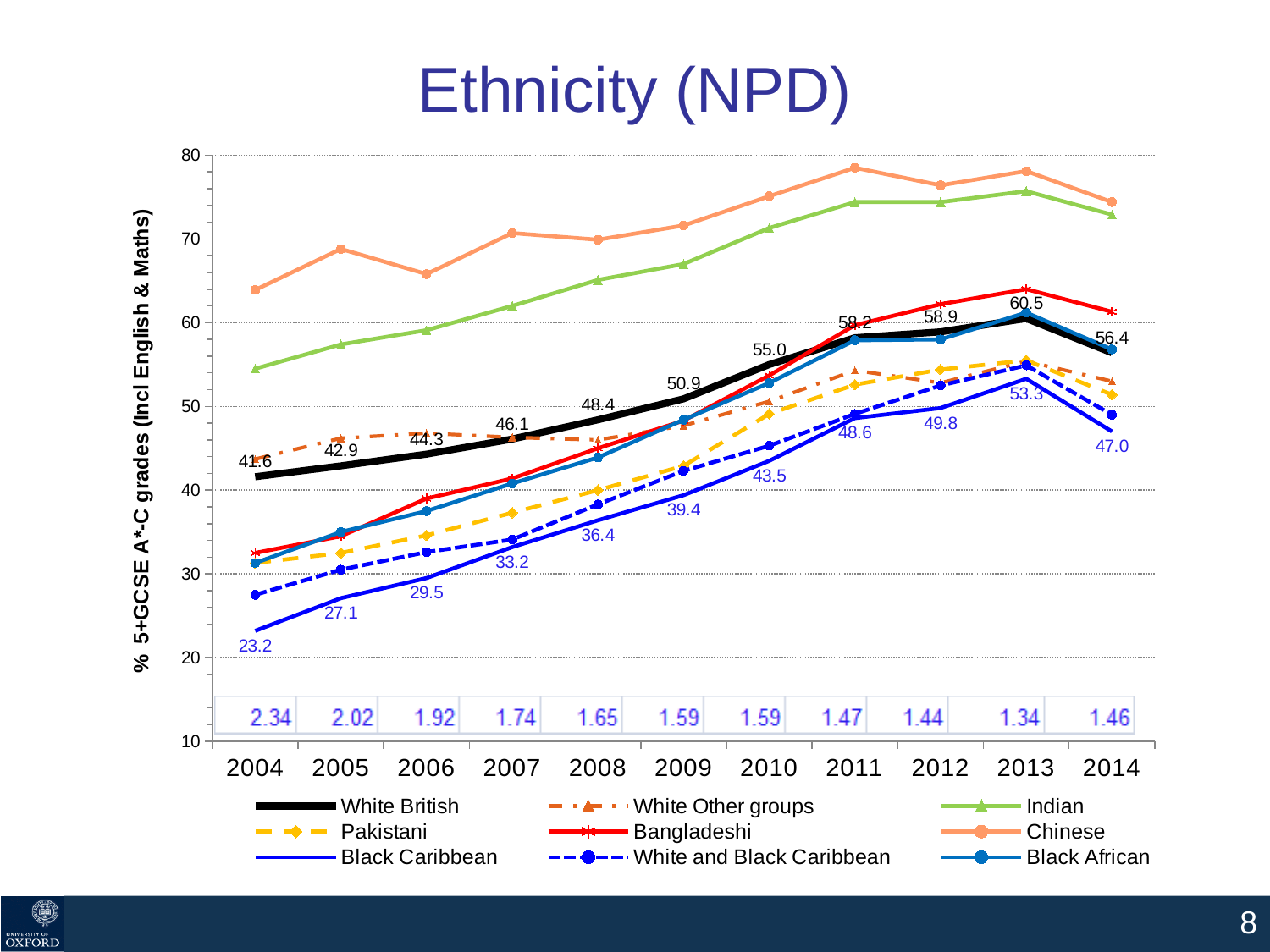
What is the difference between the White British and Black Caribbean values in 2014? 9.4 In which year is the White British value highest? 2013 What is the title of the chart? Ethnicity (NPD) Which series has the highest value in 2011? Chinese What is the value for White British in 2004? 41.6 Is the value for Indian in 2014 greater or less than 70? greater What is the value for White British in 2014? 56.4 What is the value for Black Caribbean in 2013? 53.3 In which year is the Black Caribbean value lowest? 2004 How many years are shown on the x axis? 11 What type of chart is shown on the slide? line chart How many series does the legend list? 9